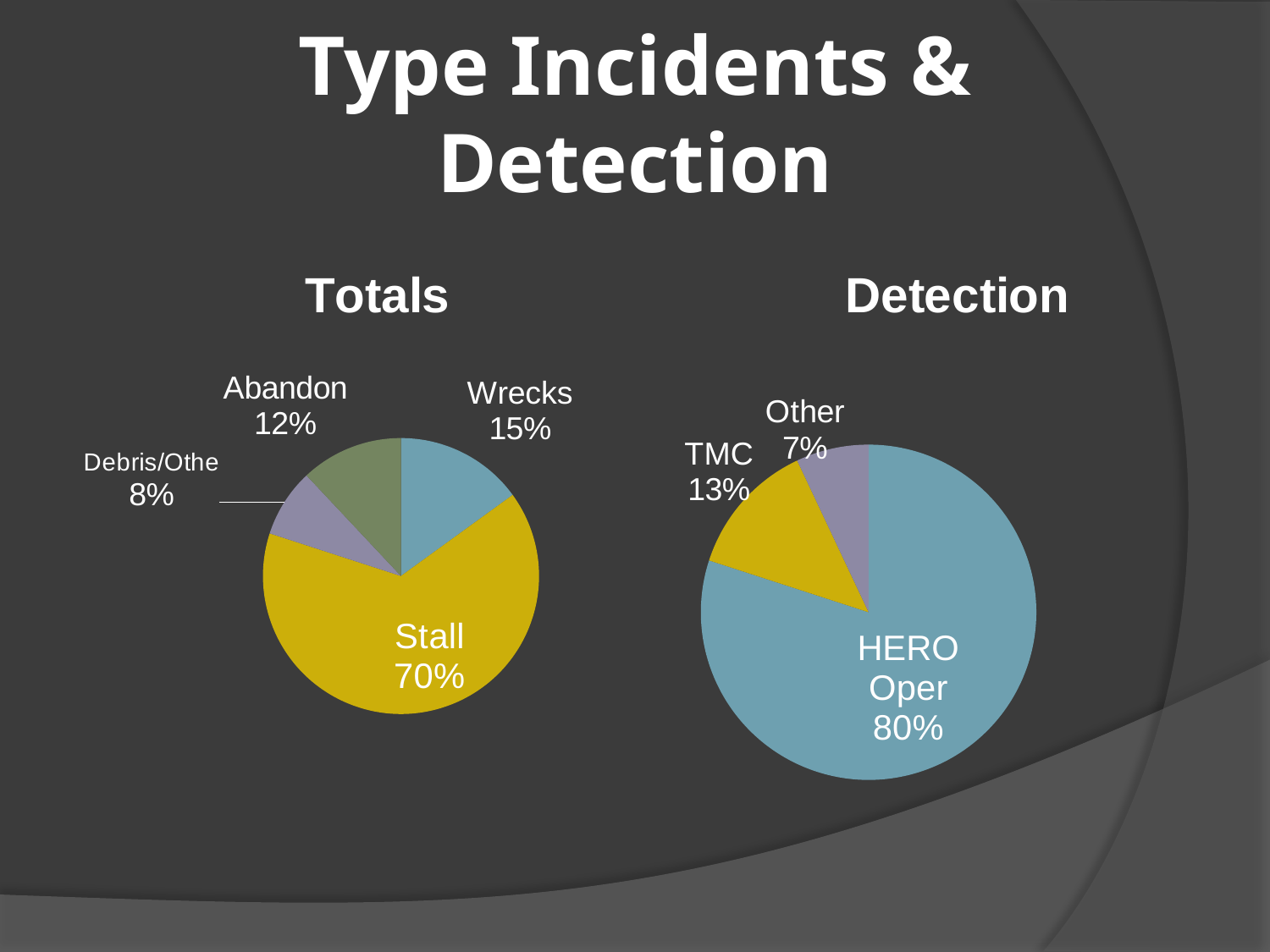
In the Totals chart, how many slices are there? 4 In the Totals chart, which category has the largest share? Stall In the Totals chart, what share does Abandon have? 12% In the Detection chart, what share does HERO Oper have? 80% In the Totals chart, what is the difference between the Stall share and the Wrecks share? 55% What kind of chart is the Detection chart? Pie chart In the Totals chart, which category has the smallest share? Debris/Othe In the Totals chart, what share does Stall have? 70% In the Detection chart, which category has the smallest share? Other In the Detection chart, what share does TMC have? 13% In the Totals chart, what share does Wrecks have? 15% In the Detection chart, which is larger, TMC or Other? TMC